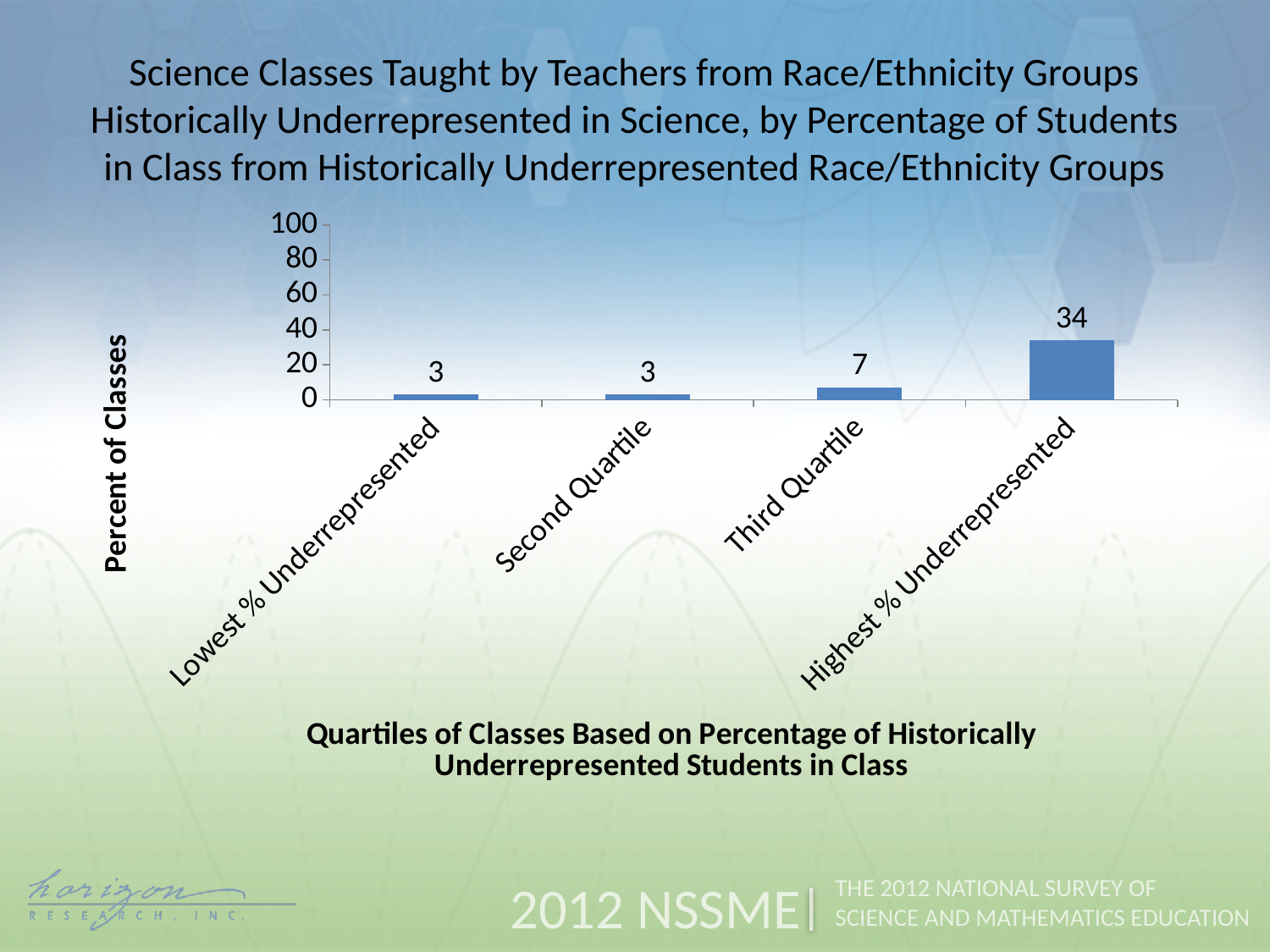
Which is larger, the value for Third Quartile or the value for Lowest % Underrepresented? Third Quartile What is the value for Third Quartile? 7 What is the value for Second Quartile? 3 What is the difference between the values for Third Quartile and Second Quartile? 4 Which category has the highest value? Highest % Underrepresented What is the value for Lowest % Underrepresented? 3 What is the value for Highest % Underrepresented? 34 What kind of chart is shown on the slide? bar chart How many categories are shown on the x axis? 4 What is the label of the y axis? Percent of Classes What is the difference between the values for Highest % Underrepresented and Third Quartile? 27 Is the value for Highest % Underrepresented greater or less than 20? greater